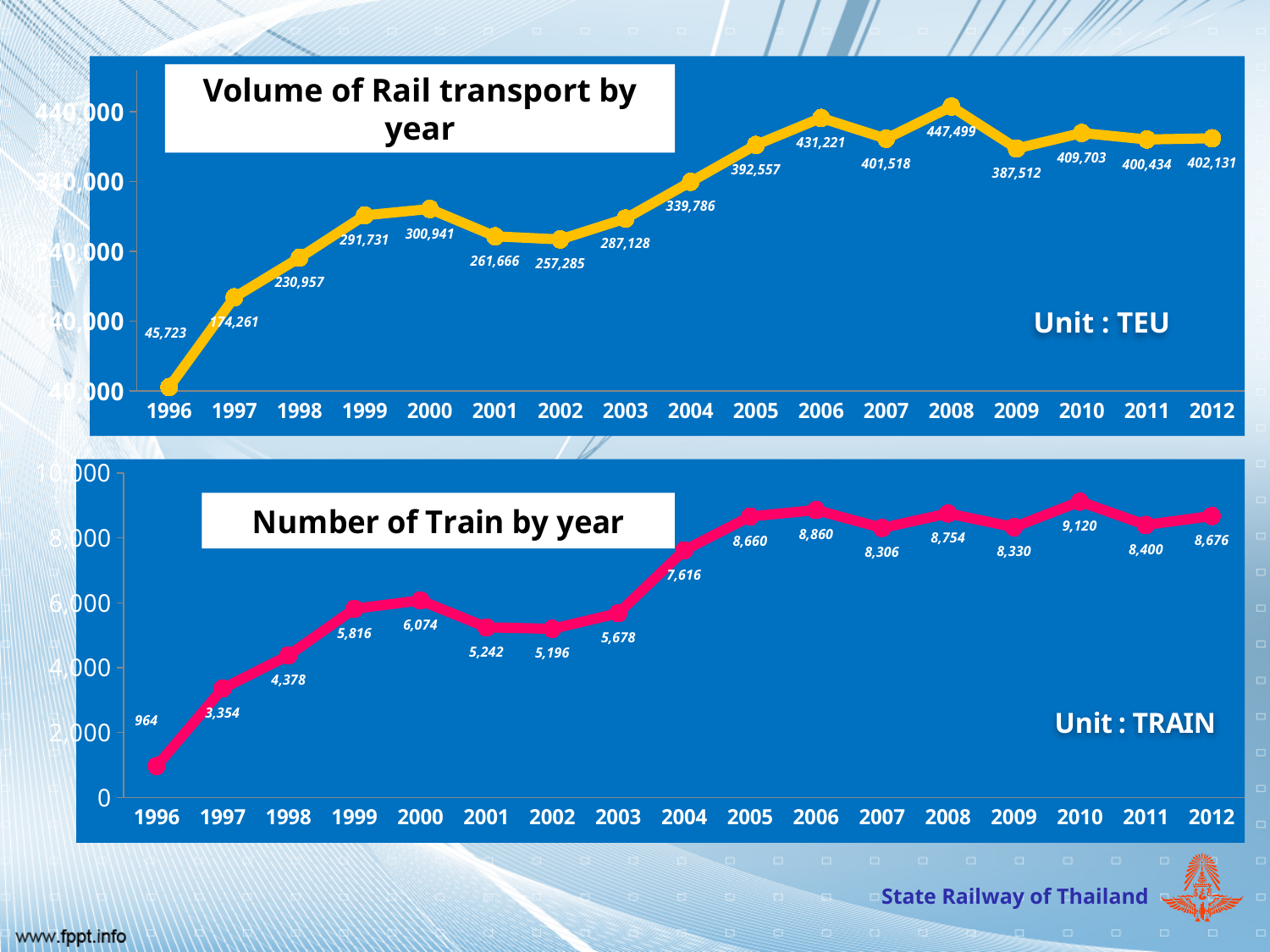
In the 'Volume of Rail transport by year' chart, which year has the lowest value? 1996 In the 'Number of Train by year' chart, what is the value for 2004? 7,616 In the 'Number of Train by year' chart, is the value for 2001 greater or less than 6,000? less What type of chart is the 'Number of Train by year' chart? Line chart What unit is shown on the 'Number of Train by year' chart? TRAIN In the 'Number of Train by year' chart, what is the difference between the 2010 value and the 2009 value? 790 In the 'Volume of Rail transport by year' chart, how many years are plotted? 17 In the 'Volume of Rail transport by year' chart, what is the value for 2008? 447,499 In the 'Volume of Rail transport by year' chart, which year has the larger value, 2000 or 2003? 2000 In the 'Volume of Rail transport by year' chart, what is the difference between the 2012 value and the 1996 value? 356,408 In the 'Number of Train by year' chart, which year has the highest value? 2010 In the 'Volume of Rail transport by year' chart, which year has the highest value? 2008